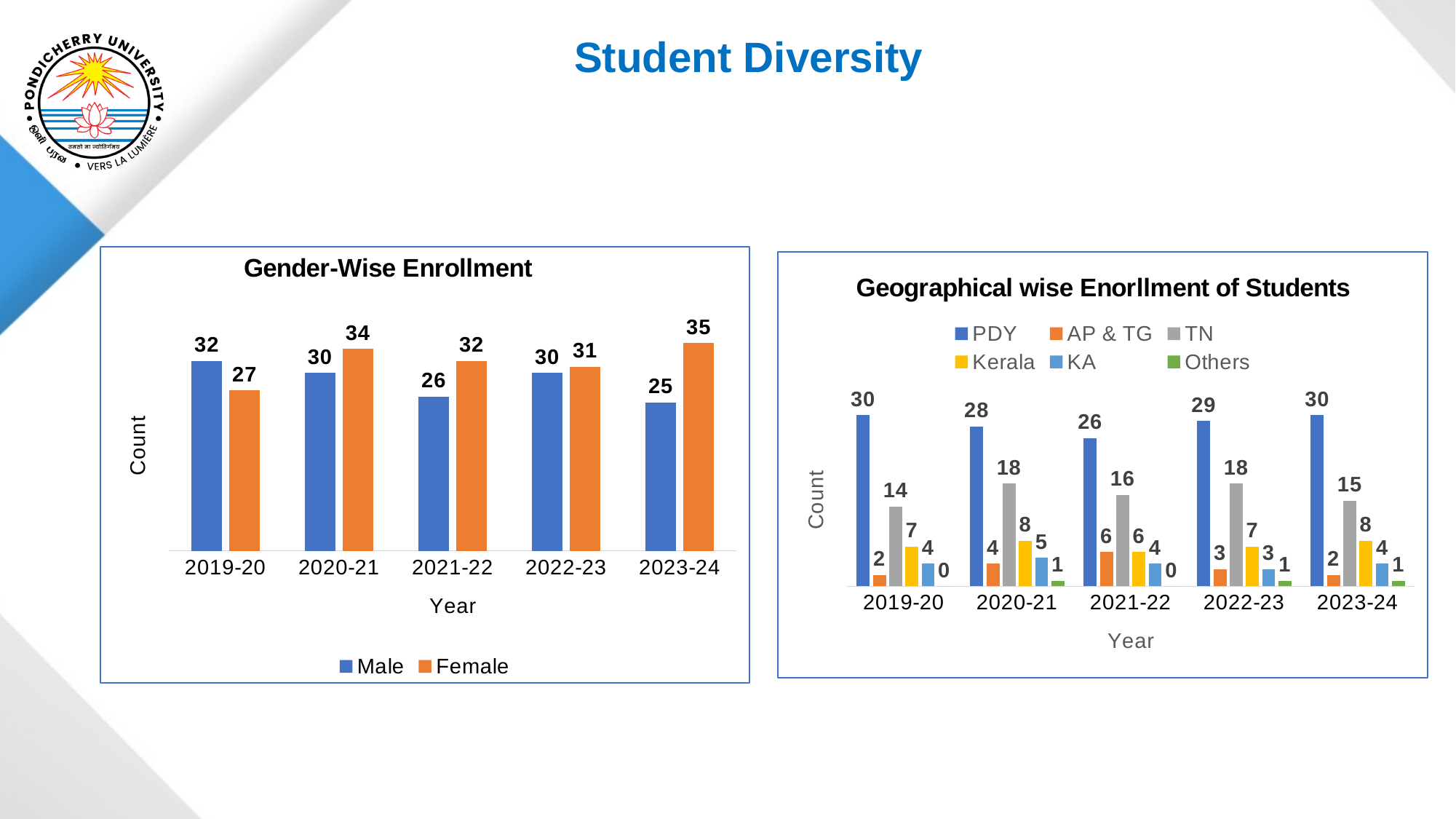
What kind of chart is the Gender-Wise Enrollment chart? Bar chart In the Geographical wise Enorllment of Students chart, which year has the lowest PDY value? 2021-22 In the Geographical wise Enorllment of Students chart, what is the difference between the PDY and TN values in 2019-20? 16 In the Gender-Wise Enrollment chart, which year has the highest Female value? 2023-24 In the Gender-Wise Enrollment chart, which year has the lowest Male value? 2023-24 How many series does the legend of the Geographical wise Enorllment of Students chart list? 6 In the Gender-Wise Enrollment chart, what is the Female value for 2023-24? 35 In the Gender-Wise Enrollment chart, which is larger in 2019-20, Male or Female? Male In the Gender-Wise Enrollment chart, what is the Male value for 2021-22? 26 In the Geographical wise Enorllment of Students chart, what is the Kerala value for 2020-21? 8 In the Gender-Wise Enrollment chart, what is the difference between the Female and Male values in 2023-24? 10 In the Geographical wise Enorllment of Students chart, what is the TN value for 2021-22? 16